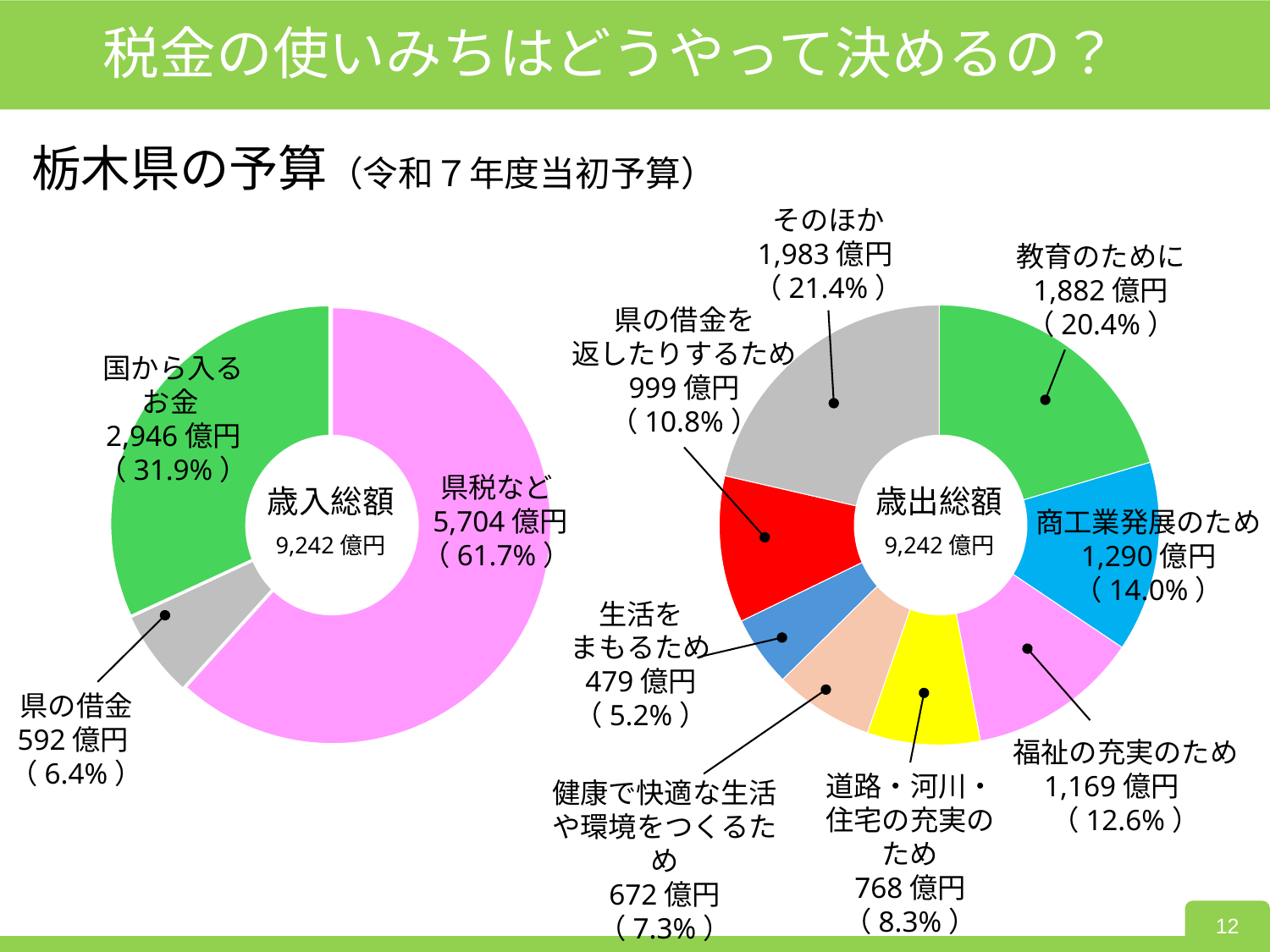
In the right chart (歳出総額), which is larger, 商工業発展のため or 福祉の充実のため? 商工業発展のため In the left chart (歳入総額), what is the value for 県税など? 5,704 億円 What kind of chart is used on this slide? Pie (donut) chart In the left chart (歳入総額), which category is the smallest? 県の借金 In the right chart (歳出総額), what share of the pie is 県の借金を返したりするため? 10.8% In the right chart (歳出総額), how many categories are shown? 8 In the left chart (歳入総額), what share of the pie is 国から入るお金? 31.9% In the left chart (歳入総額), how many categories are shown? 3 In the right chart (歳出総額), what is the value for 教育のために? 1,882 億円 In the left chart (歳入総額), what is the difference between 県税など and 国から入るお金? 2,758 億円 In the right chart (歳出総額), which category is the smallest? 生活をまもるため In the right chart (歳出総額), which category is the largest? そのほか